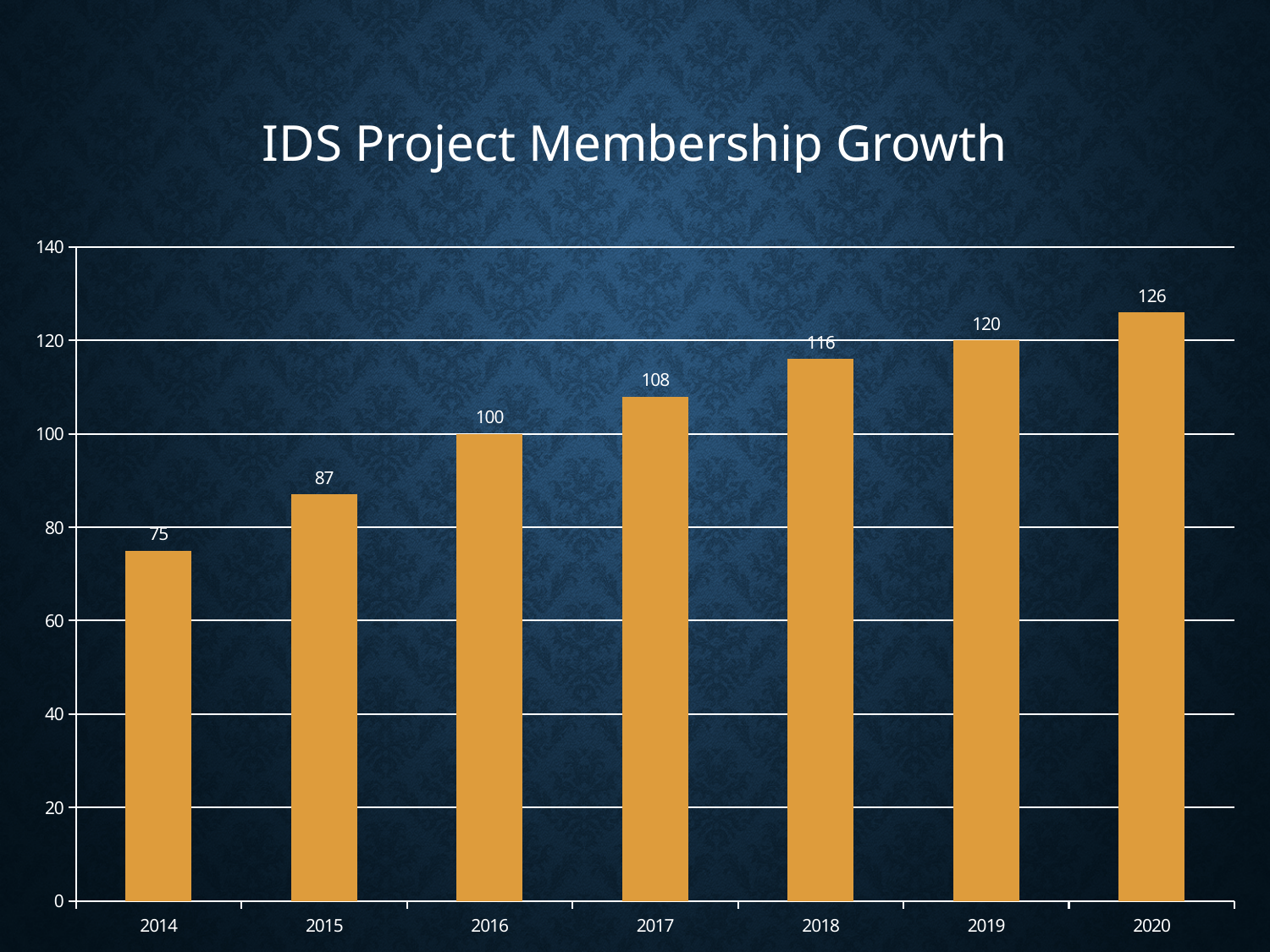
What is the difference in membership between 2020 and 2014? 51 Which year has the highest membership? 2020 Which year has the lowest membership? 2014 What kind of chart is shown on the slide? bar chart Which year has a larger membership, 2015 or 2017? 2017 Is the value for 2018 greater or less than 100? greater How many years are shown on the x axis? 7 Do the membership values rise or fall from 2014 to 2020? rise What is the title of the chart? IDS Project Membership Growth What is the membership value for 2019? 120 What is the membership value for 2016? 100 What is the difference in membership between 2018 and 2017? 8